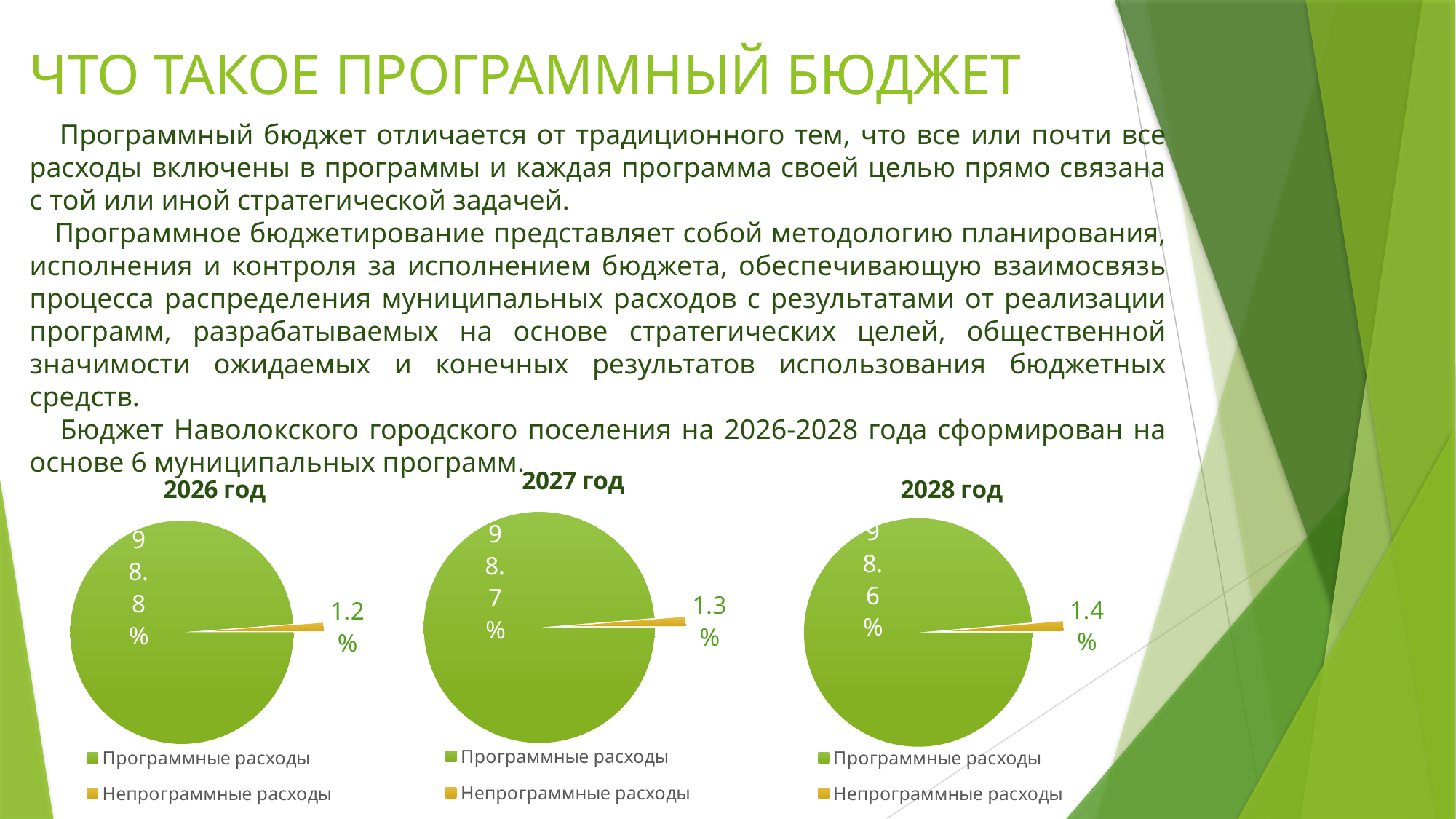
In the '2028 год' chart, which category has the largest slice? Программные расходы In the '2028 год' chart, what share do Непрограммные расходы have? 1.4% How many slices does the '2026 год' pie chart have? 2 In the '2026 год' chart, what share do Непрограммные расходы have? 1.2% In the '2027 год' chart, what share do Непрограммные расходы have? 1.3% In the '2027 год' chart, which category has the smallest slice? Непрограммные расходы In the '2026 год' chart, what share do Программные расходы have? 98.8% How many entries does the legend of the '2028 год' chart list? 2 Across the three charts from 2026 год to 2028 год, does the share of Непрограммные расходы rise or fall? Rise In the '2027 год' chart, what share do Программные расходы have? 98.7% What kind of chart is the '2026 год' chart? Pie chart In the '2028 год' chart, what share do Программные расходы have? 98.6%